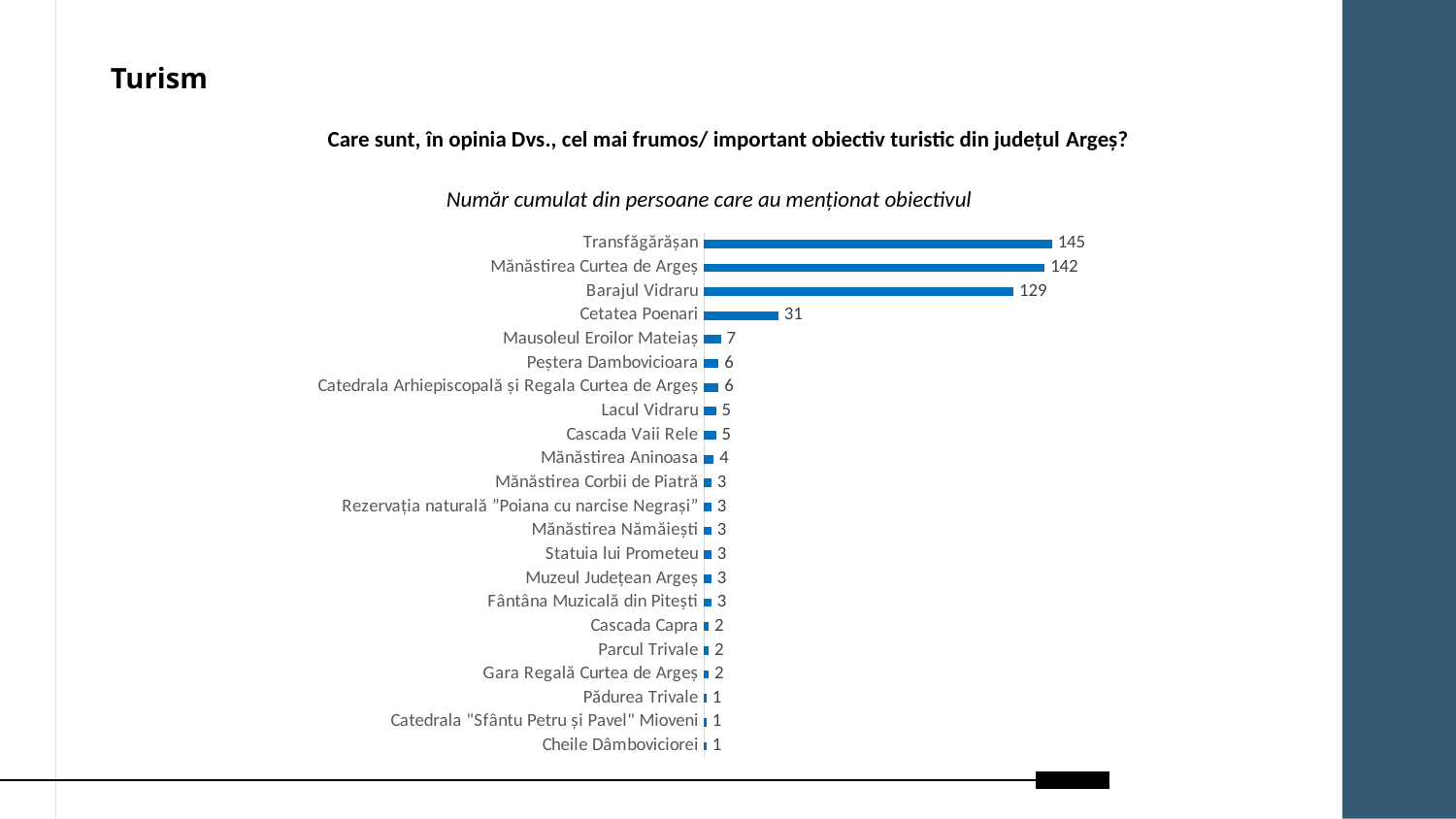
What kind of chart is shown on the slide? Bar chart What is the subtitle shown in italics above the chart? Număr cumulat din persoane care au menționat obiectivul Which is larger, the value for Cetatea Poenari or the value for Peștera Dambovicioara? Cetatea Poenari What value is shown for Mausoleul Eroilor Mateiaș? 7 What is the difference between the values for Transfăgărășan and Mănăstirea Curtea de Argeș? 3 How many categories are shown in the chart? 22 What value is shown for Cetatea Poenari? 31 What value is shown for Barajul Vidraru? 129 Which category has the highest value? Transfăgărășan Which is larger, the value for Lacul Vidraru or the value for Mănăstirea Aninoasa? Lacul Vidraru What is the difference between the values for Barajul Vidraru and Cetatea Poenari? 98 What value is shown for Transfăgărășan? 145